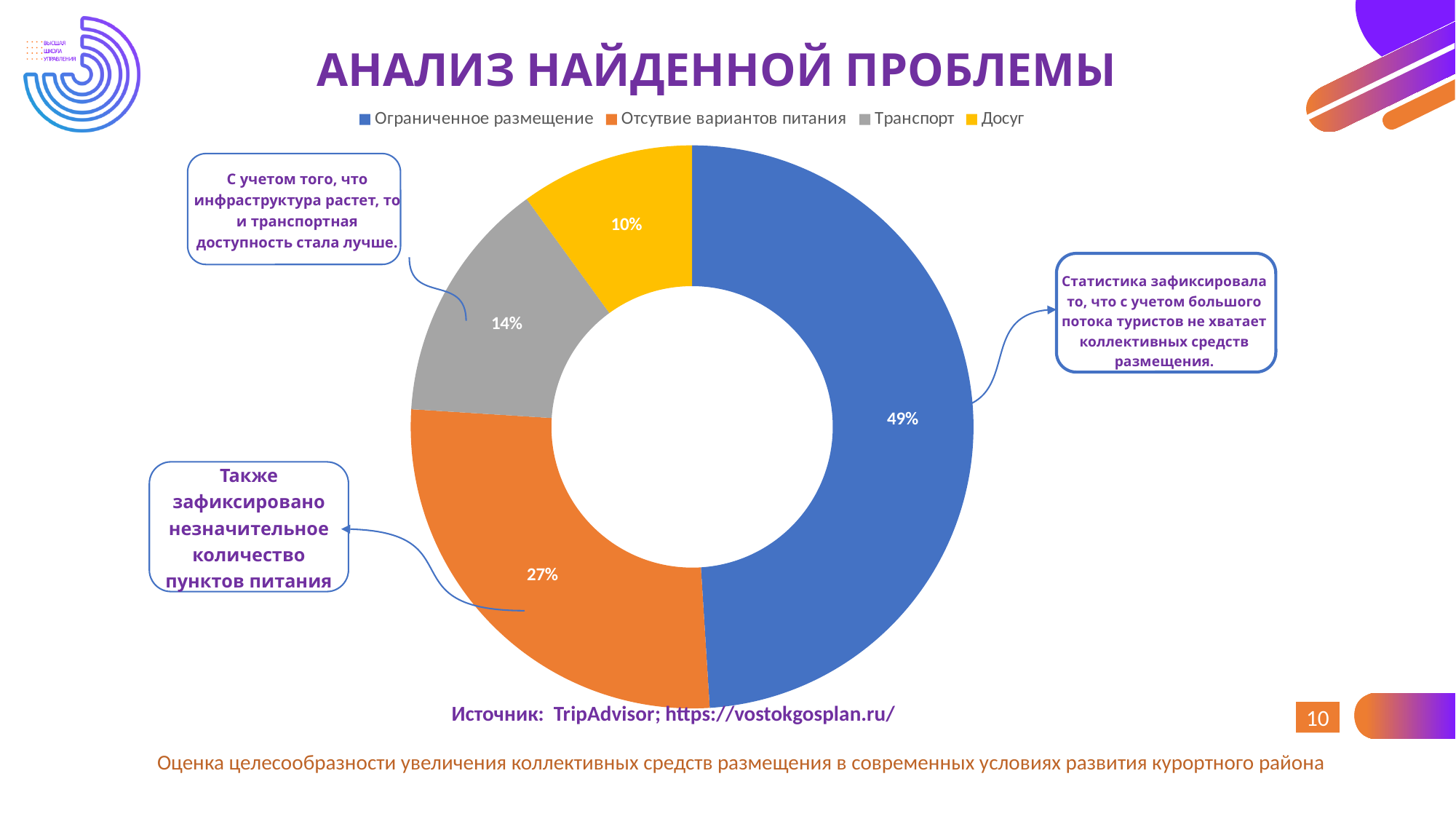
Which is larger, the share for Транспорт or the share for Досуг? Транспорт What percentage is shown for Отсутвие вариантов питания? 27% Which category has the smallest share of the chart? Досуг What percentage is shown for Ограниченное размещение? 49% What percentage is shown for Досуг? 10% What percentage is shown for Транспорт? 14% Which category has the largest share of the chart? Ограниченное размещение What colour is the slice for Досуг? Yellow What kind of chart is shown on the slide? Pie chart (doughnut) What is the difference in percentage points between Транспорт and Досуг? 4 How many categories does the chart show? 4 What is the difference in percentage points between Ограниченное размещение and Отсутвие вариантов питания? 22